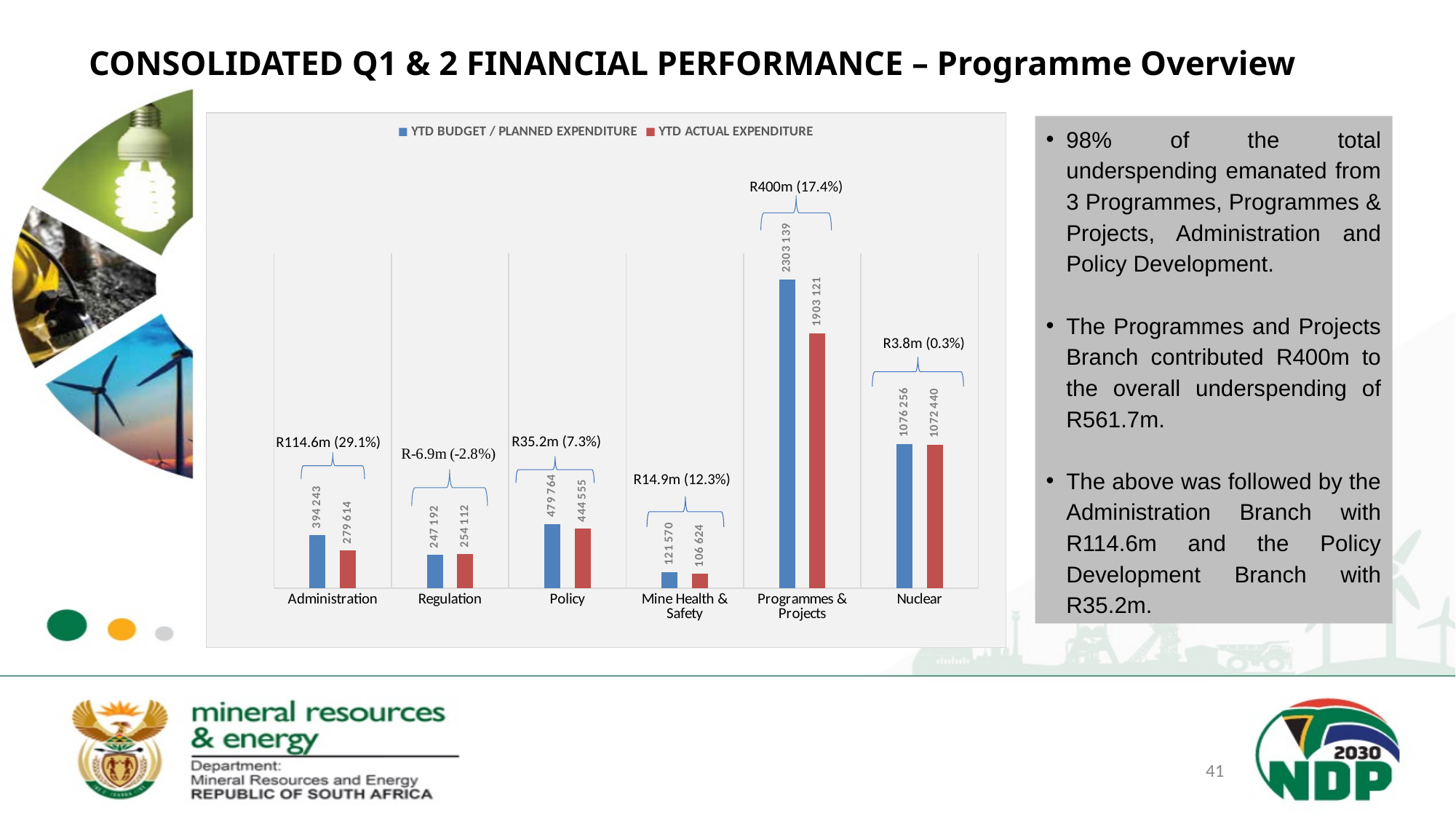
How many series does the chart legend list? 2 What is the YTD actual expenditure for Mine Health & Safety? 106 624 For Regulation, which is larger: the YTD budget / planned expenditure or the YTD actual expenditure? YTD actual expenditure Which programme has the highest YTD budget / planned expenditure? Programmes & Projects Which programme has the lowest YTD actual expenditure? Mine Health & Safety How many programmes are shown on the x axis of the chart? 6 What is the difference between the YTD budget and YTD actual expenditure for Programmes & Projects? 400 018 What is the YTD budget / planned expenditure for Administration? 394 243 What is the difference between the YTD budget and YTD actual expenditure for Administration? 114 629 What kind of chart is shown on the slide? Bar chart What is the YTD budget / planned expenditure for Nuclear? 1076 256 What is the YTD actual expenditure for Programmes & Projects? 1903 121